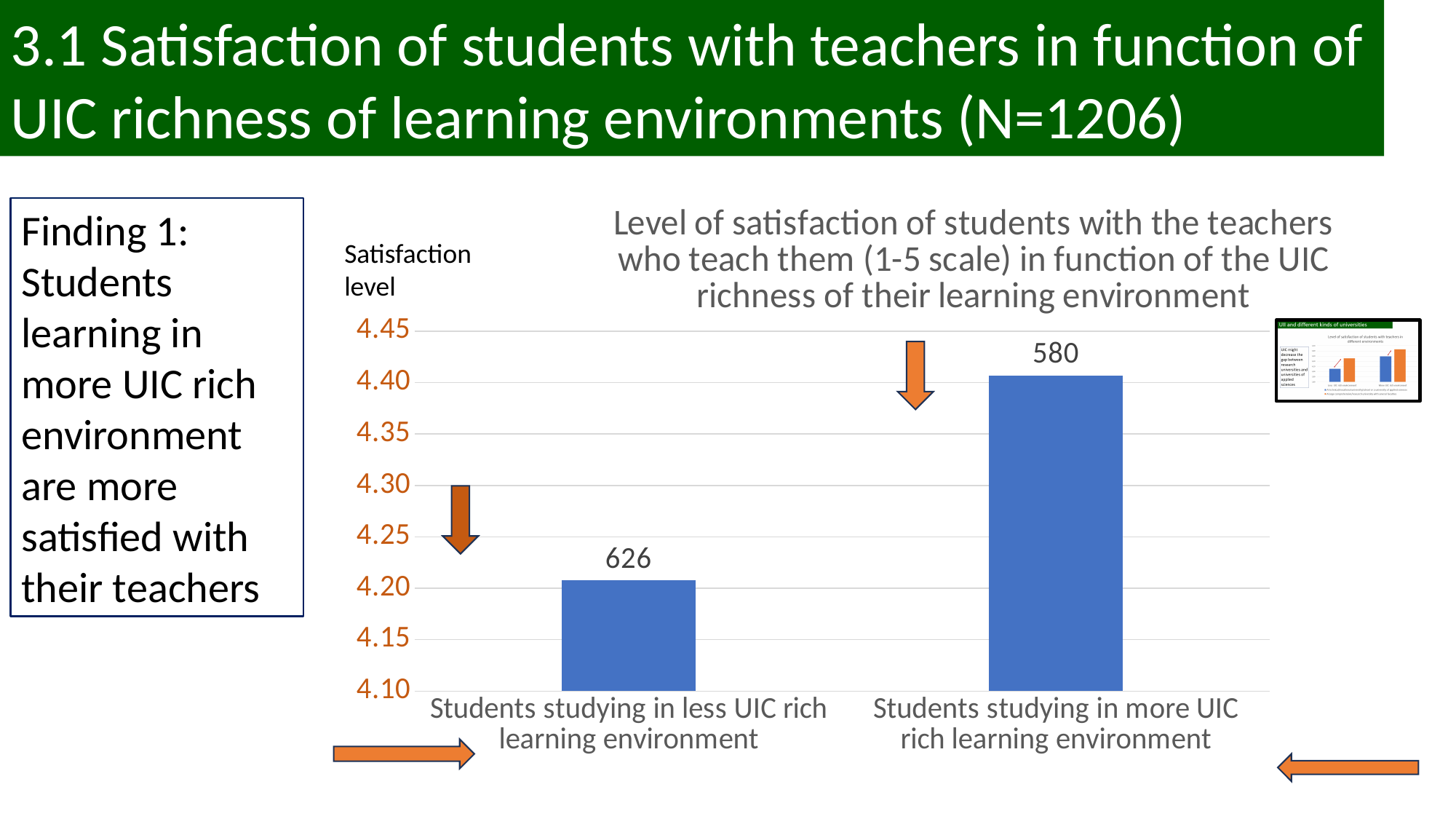
Which category has the lowest satisfaction level? Students studying in less UIC rich learning environment Which category has the highest satisfaction level? Students studying in more UIC rich learning environment How many categories (bars) does the chart show? 2 Is the satisfaction level for students studying in a more UIC rich learning environment greater or less than 4.35? greater What kind of chart is shown on the slide? bar chart What number is printed above the bar for students studying in a more UIC rich learning environment? 580 Which is larger: the satisfaction level for students in a less UIC rich learning environment or for students in a more UIC rich learning environment? Students studying in more UIC rich learning environment Is the satisfaction level for students studying in a less UIC rich learning environment greater or less than 4.25? less Is the satisfaction level for students studying in a more UIC rich learning environment greater or less than 4.45? less What number is printed above the bar for students studying in a less UIC rich learning environment? 626 What is the label of the vertical axis of the chart? Satisfaction level Do the bar values rise or fall from left to right along the x axis? rise